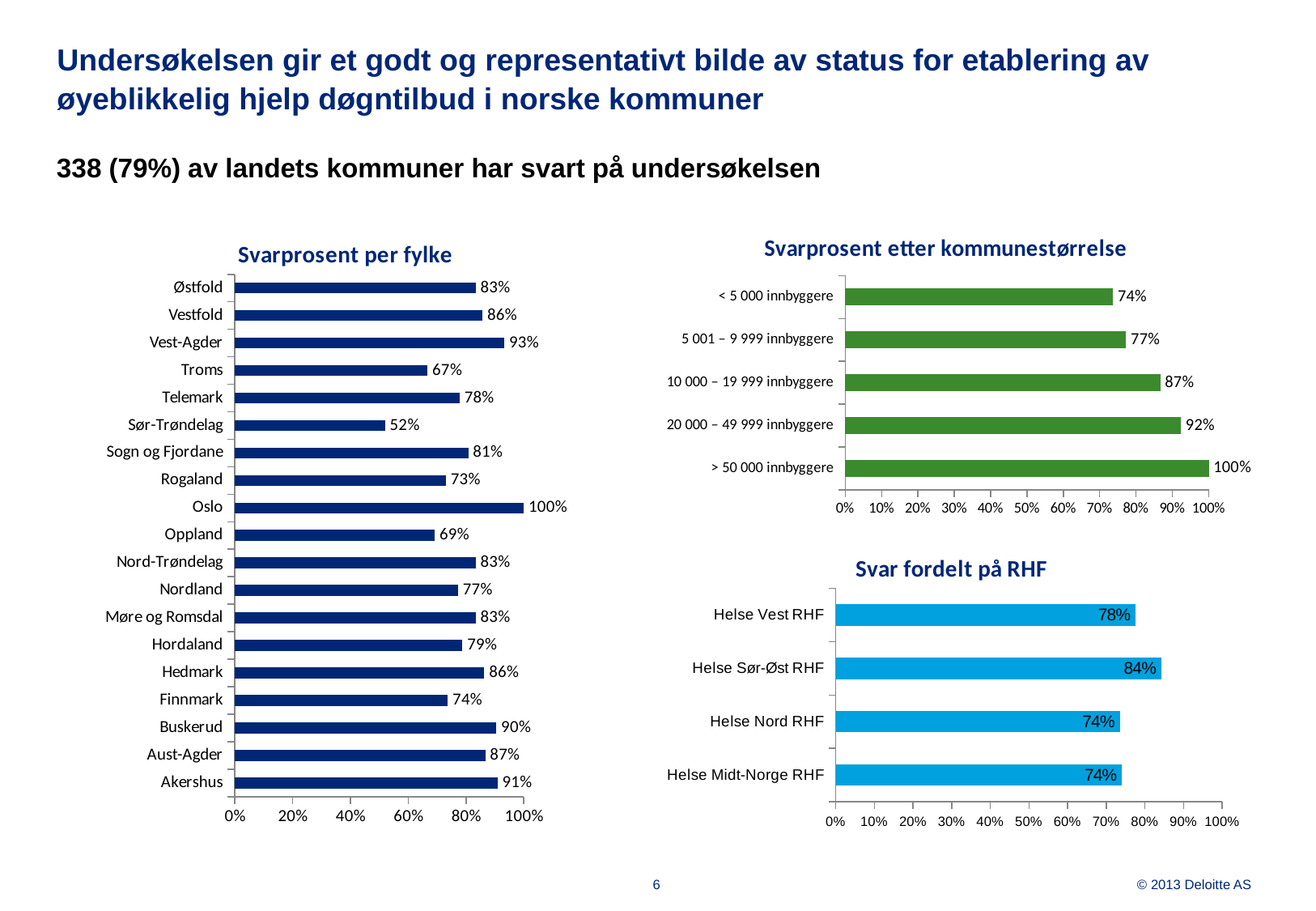
In the 'Svarprosent per fylke' chart, which fylke has the highest response rate? Oslo In the 'Svarprosent per fylke' chart, which fylke has the lowest response rate? Sør-Trøndelag In the 'Svarprosent per fylke' chart, what is the value for Sør-Trøndelag? 52% In the 'Svarprosent etter kommunestørrelse' chart, do the values rise or fall as municipality size increases from top to bottom? rise What kind of chart is 'Svar fordelt på RHF'? bar chart In the 'Svar fordelt på RHF' chart, which is larger, Helse Vest RHF or Helse Nord RHF? Helse Vest RHF In the 'Svarprosent etter kommunestørrelse' chart, what is the value for '10 000 – 19 999 innbyggere'? 87% In the 'Svarprosent per fylke' chart, what is the difference between Vest-Agder and Troms? 26% In the 'Svar fordelt på RHF' chart, what is the value for Helse Sør-Øst RHF? 84% In the 'Svar fordelt på RHF' chart, how many RHF categories are shown? 4 In the 'Svarprosent etter kommunestørrelse' chart, which category has the lowest value? < 5 000 innbyggere In the 'Svarprosent per fylke' chart, how many fylker are listed? 19